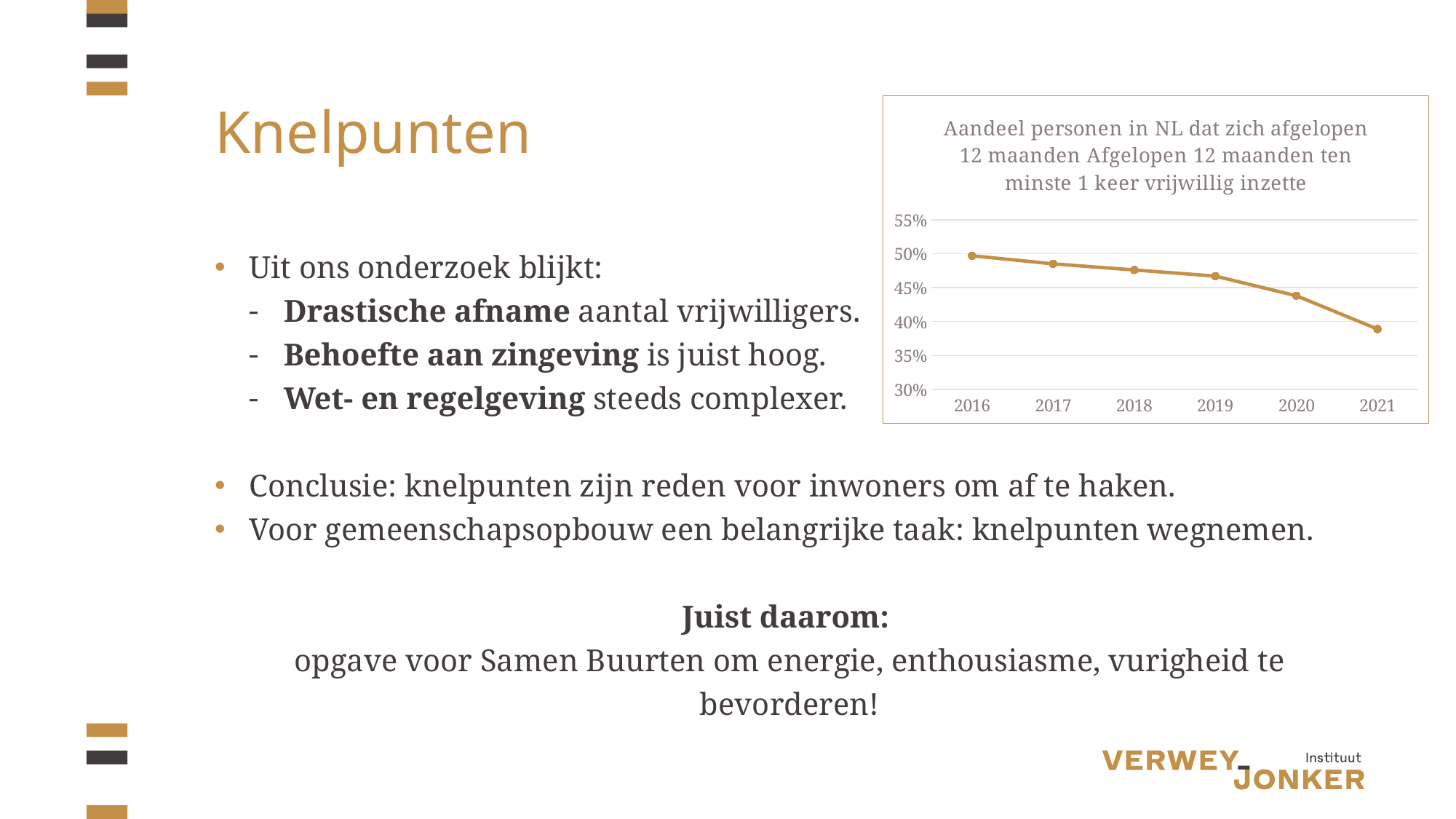
Is the value for 2021 greater or less than 40%? less Which year has the larger value, 2017 or 2020? 2017 Is the value for 2016 greater or less than 45%? greater Which year has the lowest value in the chart? 2021 Do the values in the chart rise or fall from 2016 to 2021? fall Which year has the highest value in the chart? 2016 What is the first year shown on the x axis of the chart? 2016 What kind of chart is shown on the slide? line chart How many years are plotted on the x axis of the chart? 6 Is the value for 2020 greater or less than 40%? greater What is the highest value shown on the y axis of the chart? 55%